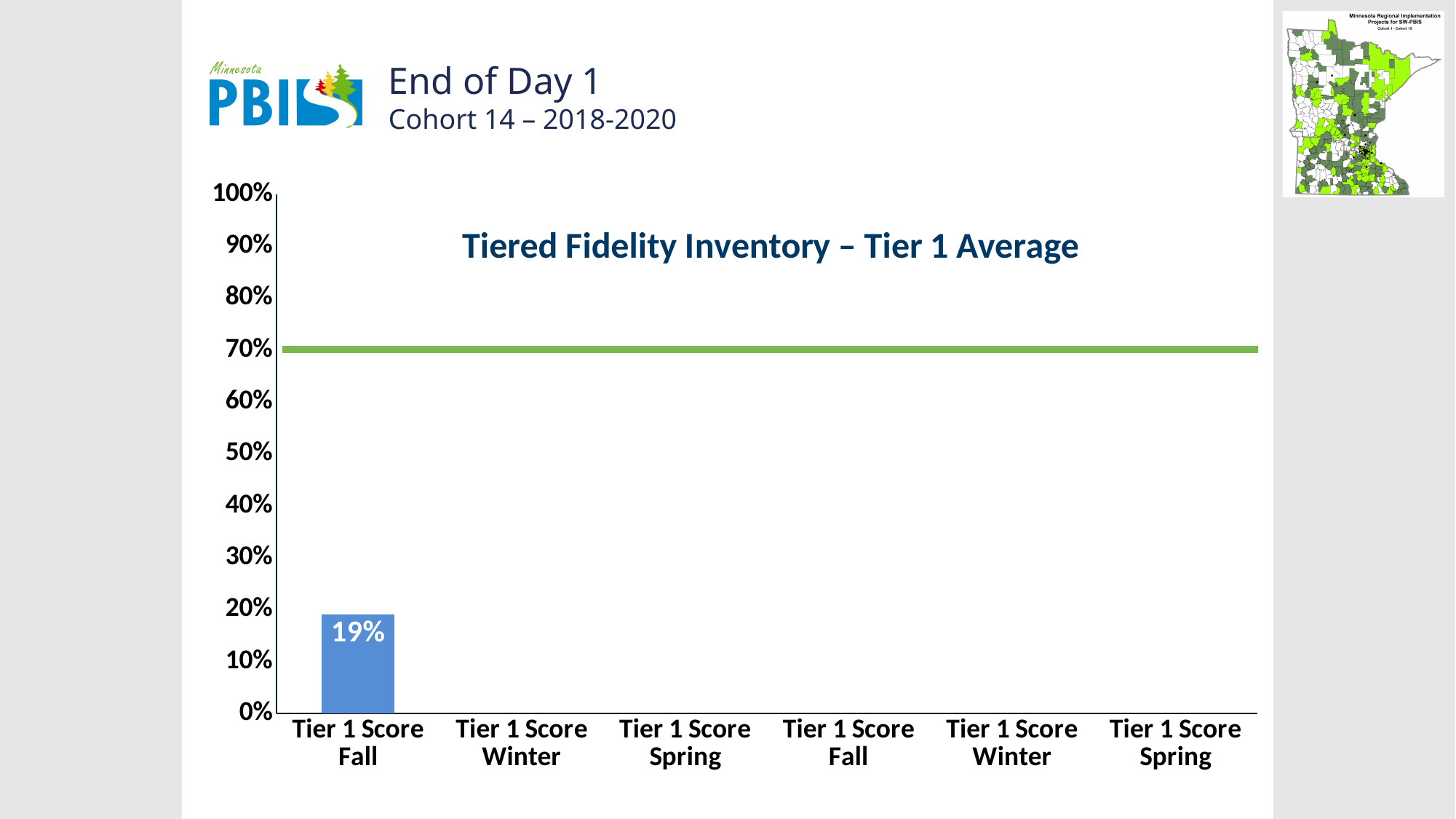
How many categories are labelled along the x axis? 6 What is the title of the chart? Tiered Fidelity Inventory – Tier 1 Average Is the value for the first Tier 1 Score Fall bar greater or less than 20%? less Is the first Tier 1 Score Fall bar above or below the green 70% line? below What kind of chart is shown on the slide? bar chart How many bars are plotted on the chart? 1 What is the maximum value shown on the y axis? 100% Is the value for the first Tier 1 Score Fall bar greater or less than 10%? greater What is the difference between the green 70% line and the first Tier 1 Score Fall bar? 51% Which category has the only plotted bar? Tier 1 Score Fall (first) At what percentage does the green horizontal line sit? 70% What is the value of the first Tier 1 Score Fall bar? 19%